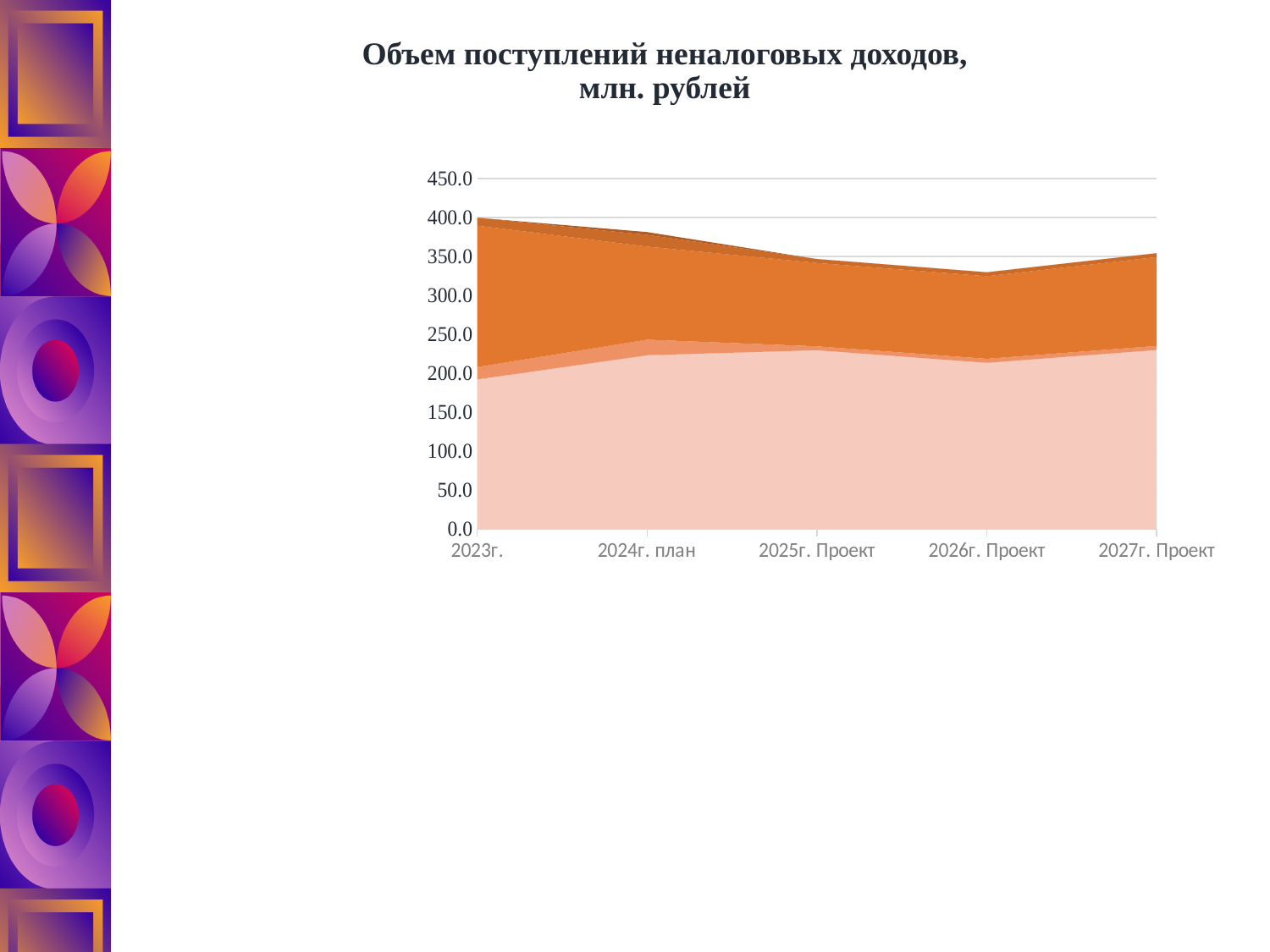
In which category does the stacked total reach its lowest point? 2026г. Проект Is the value of the bottom (lightest) series for 2024г. план greater or less than 200? greater Which has the larger stacked total, 2023г. or 2026г. Проект? 2023г. Is the stacked total for 2024г. план greater or less than 400? less Is the stacked total for 2026г. Проект greater or less than 350? less How many categories are shown along the x axis of the chart? 5 Does the stacked total rise or fall from 2023г. to 2026г. Проект? fall What is the title of the chart? Объем поступлений неналоговых доходов, млн. рублей In which category does the stacked total reach its highest point? 2023г. What is the highest value shown on the vertical axis of the chart? 450.0 What kind of chart is shown on the slide? area chart